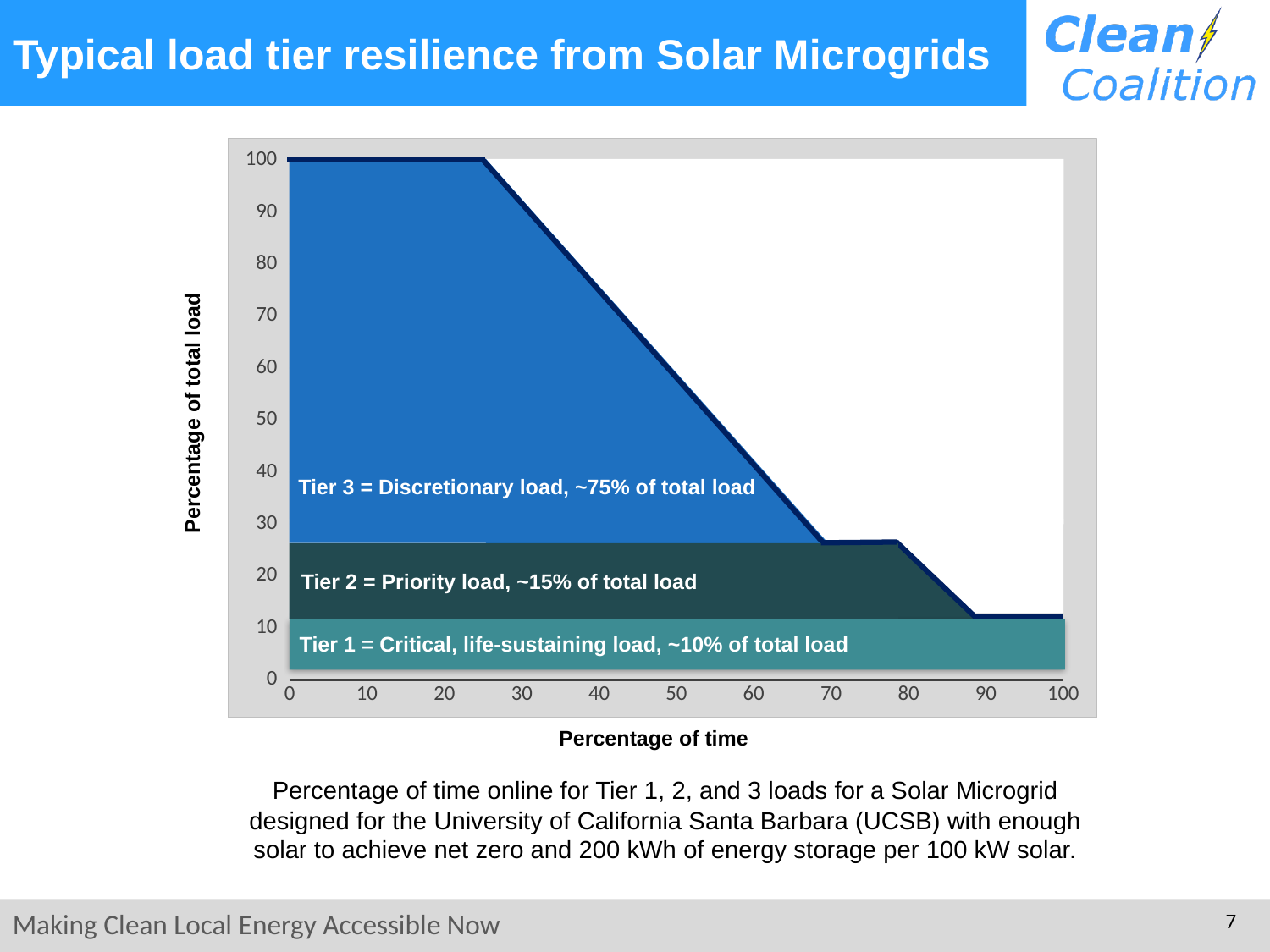
What is the label of the x axis? Percentage of time According to the label on the chart, what share of total load is Tier 2 (Priority load)? ~15% What is the title of the chart on the slide? Typical load tier resilience from Solar Microgrids Does the percentage of total load rise or fall as the percentage of time increases along the x axis? Fall According to the label on the chart, what share of total load is Tier 3 (Discretionary load)? ~75% What kind of chart is shown on the slide? Area chart How many load tiers are labelled on the chart? 3 According to the label on the chart, what share of total load is Tier 1 (Critical, life-sustaining load)? ~10% Is the percentage of total load at 100% of time greater or less than 20? less Is the percentage of total load at 10% of time greater or less than 90? greater Which is larger: the percentage of total load at 20% of time or at 80% of time? 20% of time Is the percentage of total load at 50% of time greater or less than 50? greater